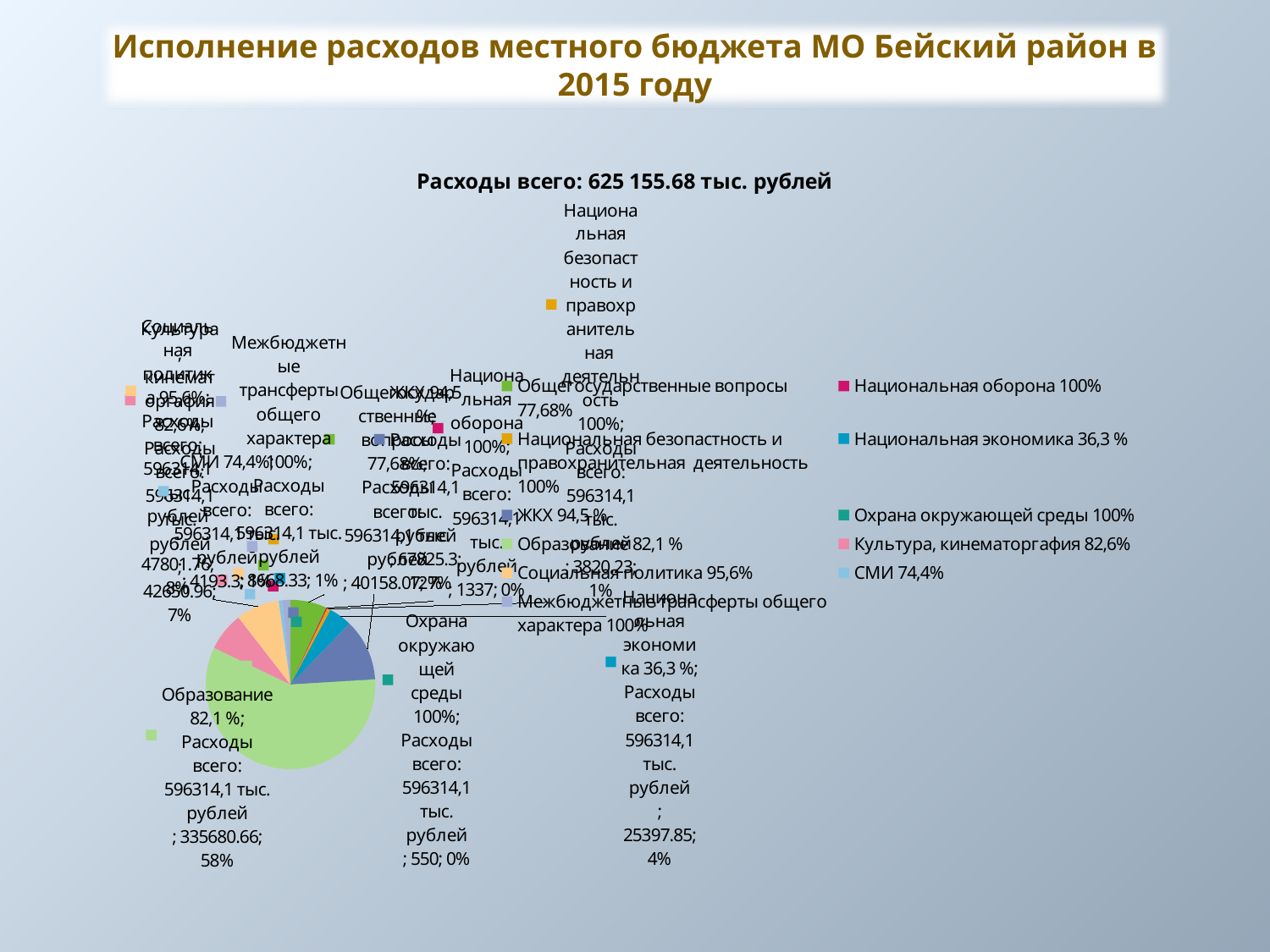
What share of the pie does Образование take? 58% What kind of chart is shown on the slide? pie chart What value is shown for Охрана окружающей среды? 550 What value is shown for Образование? 335680.66 Which category has the largest slice of the pie? Образование What value is shown for Национальная безопастность и правохранительная деятельность? 3820.23 What execution percentage does the legend show for ЖКХ? 94,5 % What is the chart's title? Расходы всего: 625 155.68 тыс. рублей Which is larger, the slice for Образование or the slice for Национальная экономика? Образование What value is shown for Национальная экономика? 25397.85 What share of the pie does Национальная экономика take? 4% How many categories does the legend list? 11